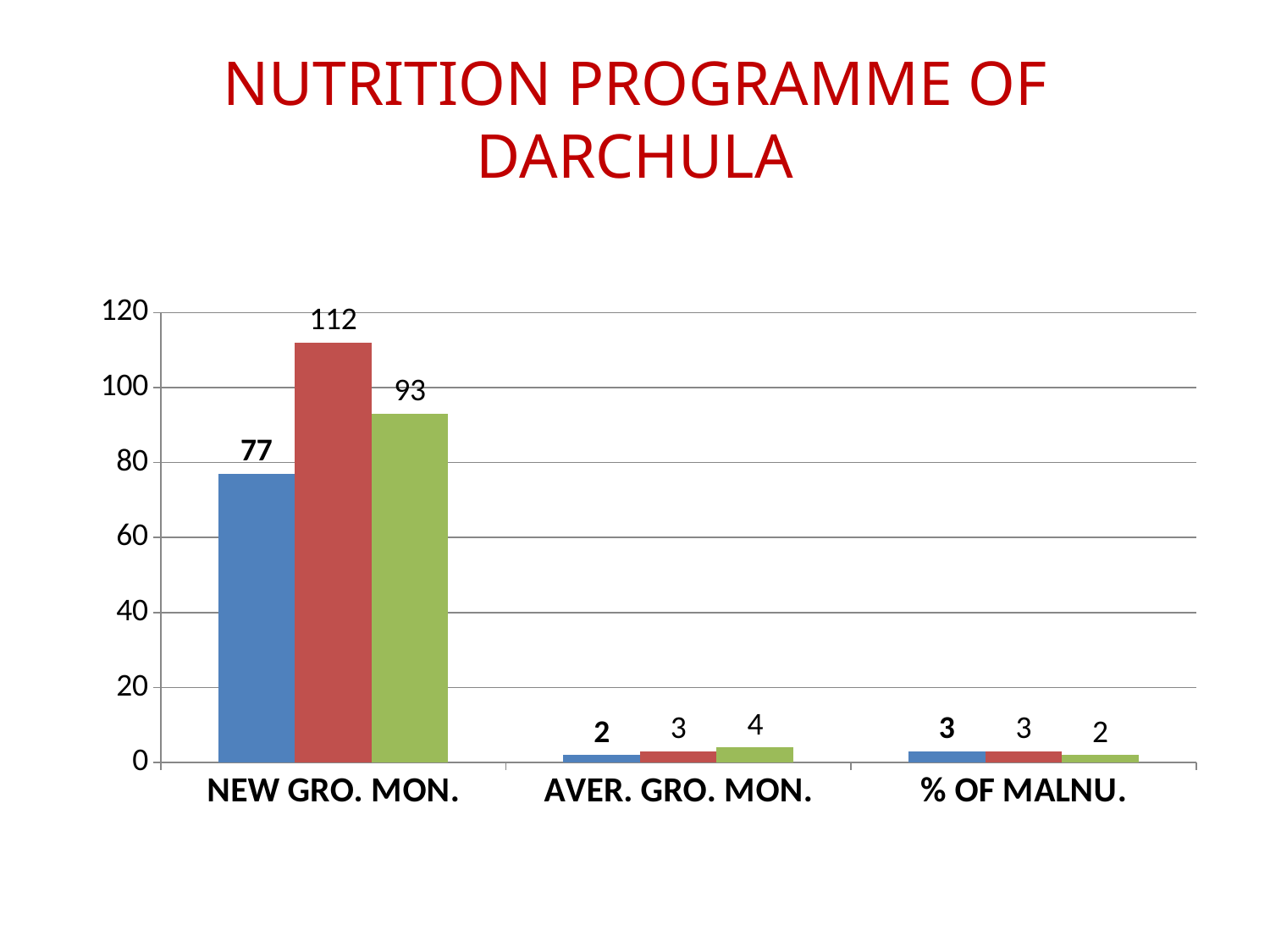
For NEW GRO. MON., is the green bar or the blue bar larger? the green bar What is the value of the green bar for AVER. GRO. MON.? 4 What is the value of the green bar for NEW GRO. MON.? 93 What is the value of the red bar for NEW GRO. MON.? 112 Which bar in the NEW GRO. MON. category has the highest value? the red bar (112) How many categories are shown on the x axis of the chart? 3 What is the value of the green bar for % OF MALNU.? 2 What type of chart is shown on the slide? bar chart Is the value of the red bar for NEW GRO. MON. greater or less than 100? greater Which category has the lowest value for the blue bar? AVER. GRO. MON. What is the value of the blue bar for NEW GRO. MON.? 77 What is the difference between the red bar and the blue bar for NEW GRO. MON.? 35